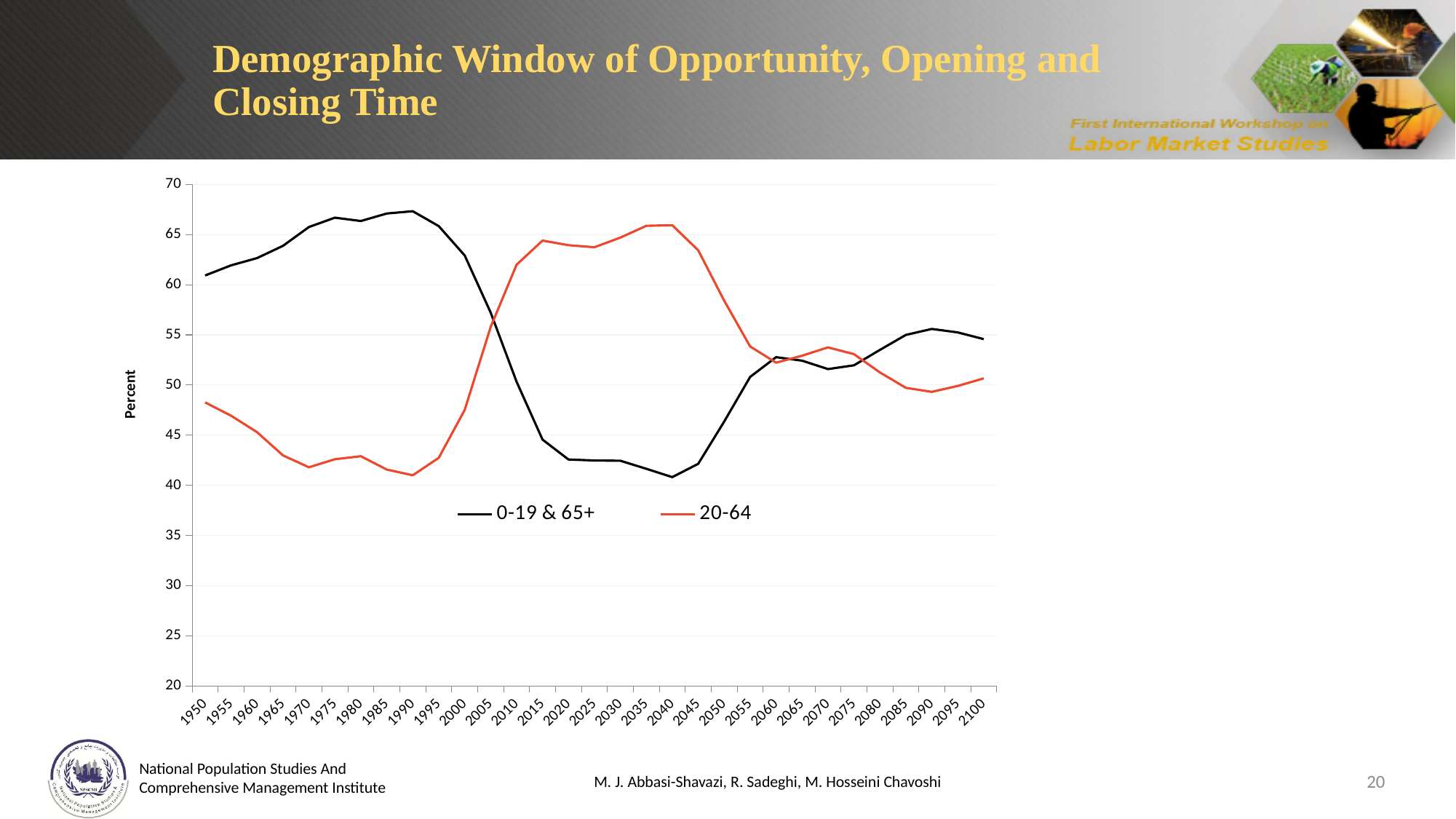
In 2040, which series has the higher value, 0-19 & 65+ or 20-64? 20-64 In 1950, which series has the higher value, 0-19 & 65+ or 20-64? 0-19 & 65+ What is the label of the y axis? Percent Is the value for 0-19 & 65+ in 1990 greater or less than 65? greater Does the 0-19 & 65+ series rise or fall between 1995 and 2040? fall Which colour is used for the 20-64 series? red Is the value for 20-64 in 1990 greater or less than 45? less What kind of chart is shown on the slide? line chart Is the value for 20-64 in 2040 greater or less than 65? greater How many years are labelled along the x axis? 31 How many series does the legend list? 2